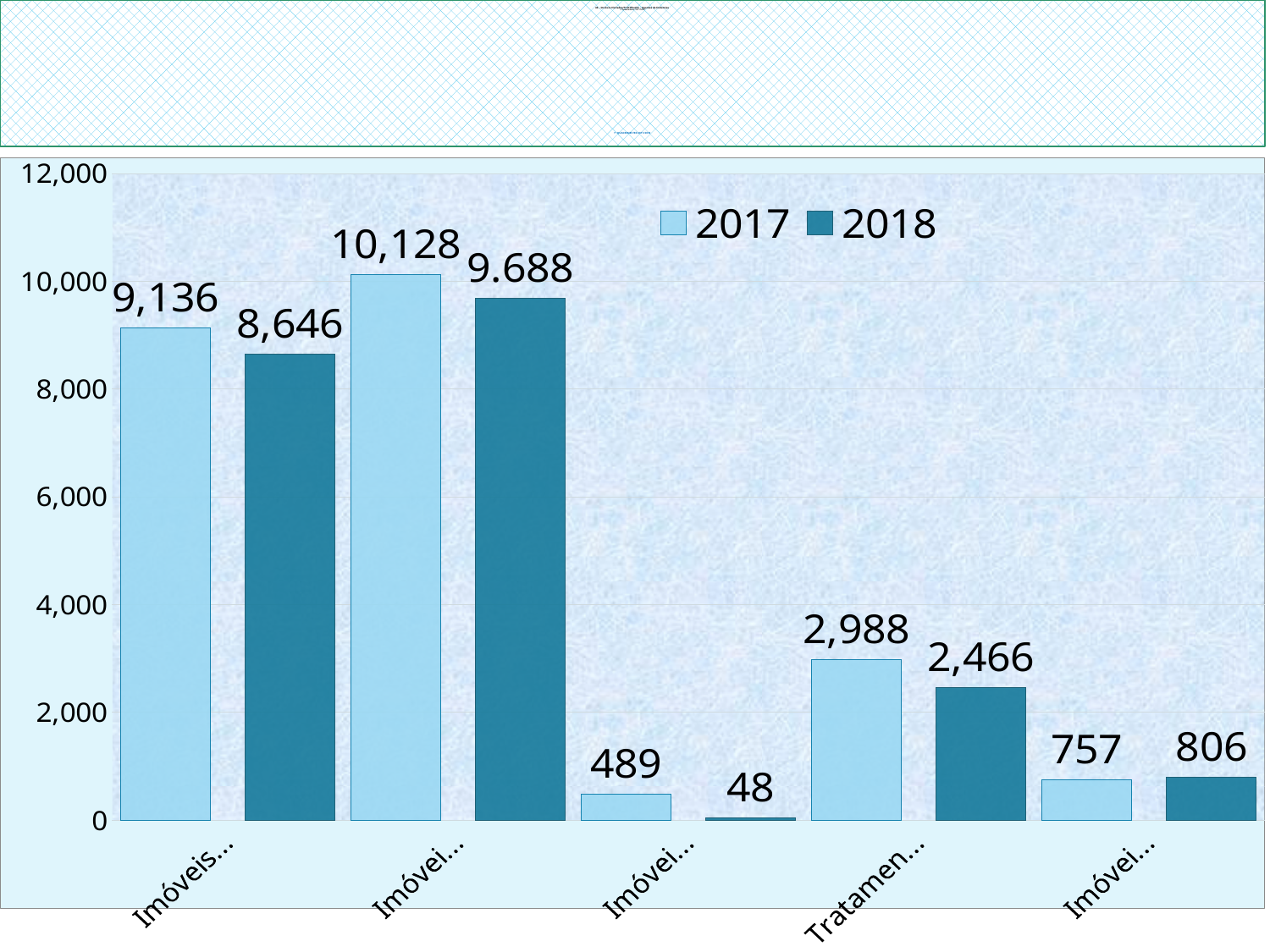
What is the 2017 value for the third category group from the left? 489 What is the 2018 value for the first category group from the left? 8,646 What is the highest value among the 2017 bars? 10,128 In the fifth category group from the left, which series has the larger value, 2017 or 2018? 2018 What is the difference between the 2017 and 2018 values in the first category group from the left? 490 What is the difference between the 2017 and 2018 values in the fourth category group from the left? 522 What is the lowest value among the 2018 bars? 48 How many category groups are plotted along the x axis? 5 Is the 2018 value in the second category group from the left greater or less than 8,000? greater What kind of chart is shown on the slide? bar chart How many series does the legend list? 2 What are the two entries in the legend? 2017 and 2018